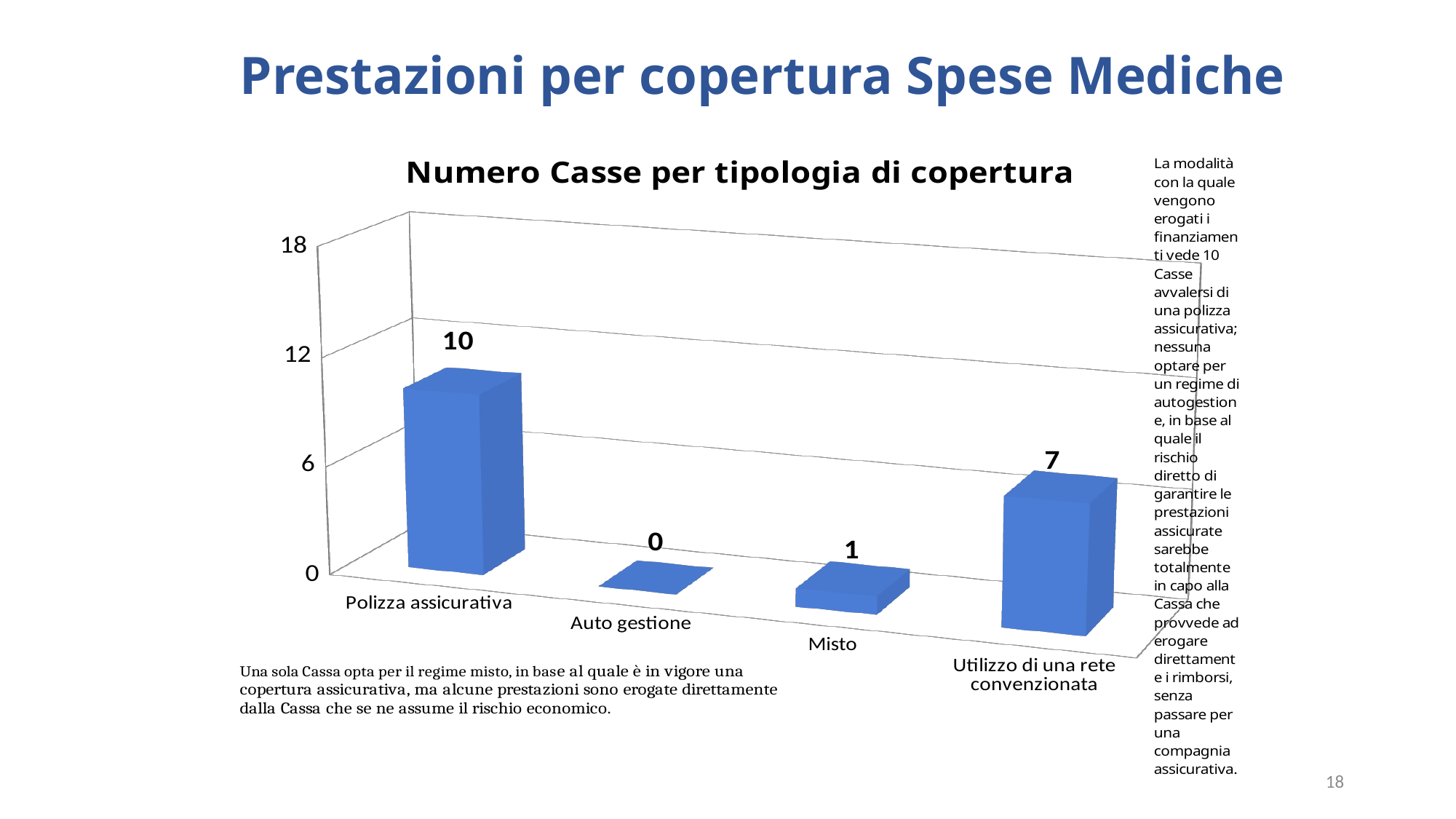
What is the title of the chart? Numero Casse per tipologia di copertura What is the difference between the values for Polizza assicurativa and Utilizzo di una rete convenzionata? 3 What is the value for Polizza assicurativa? 10 What is the value for Auto gestione? 0 Which category has the lowest value? Auto gestione Which is larger, the value for Misto or the value for Utilizzo di una rete convenzionata? Utilizzo di una rete convenzionata How many categories are shown on the x axis? 4 What is the value for Misto? 1 Is the value for Polizza assicurativa greater or less than 6? greater What is the value for Utilizzo di una rete convenzionata? 7 Which category has the highest value? Polizza assicurativa What kind of chart is shown on the slide? bar chart